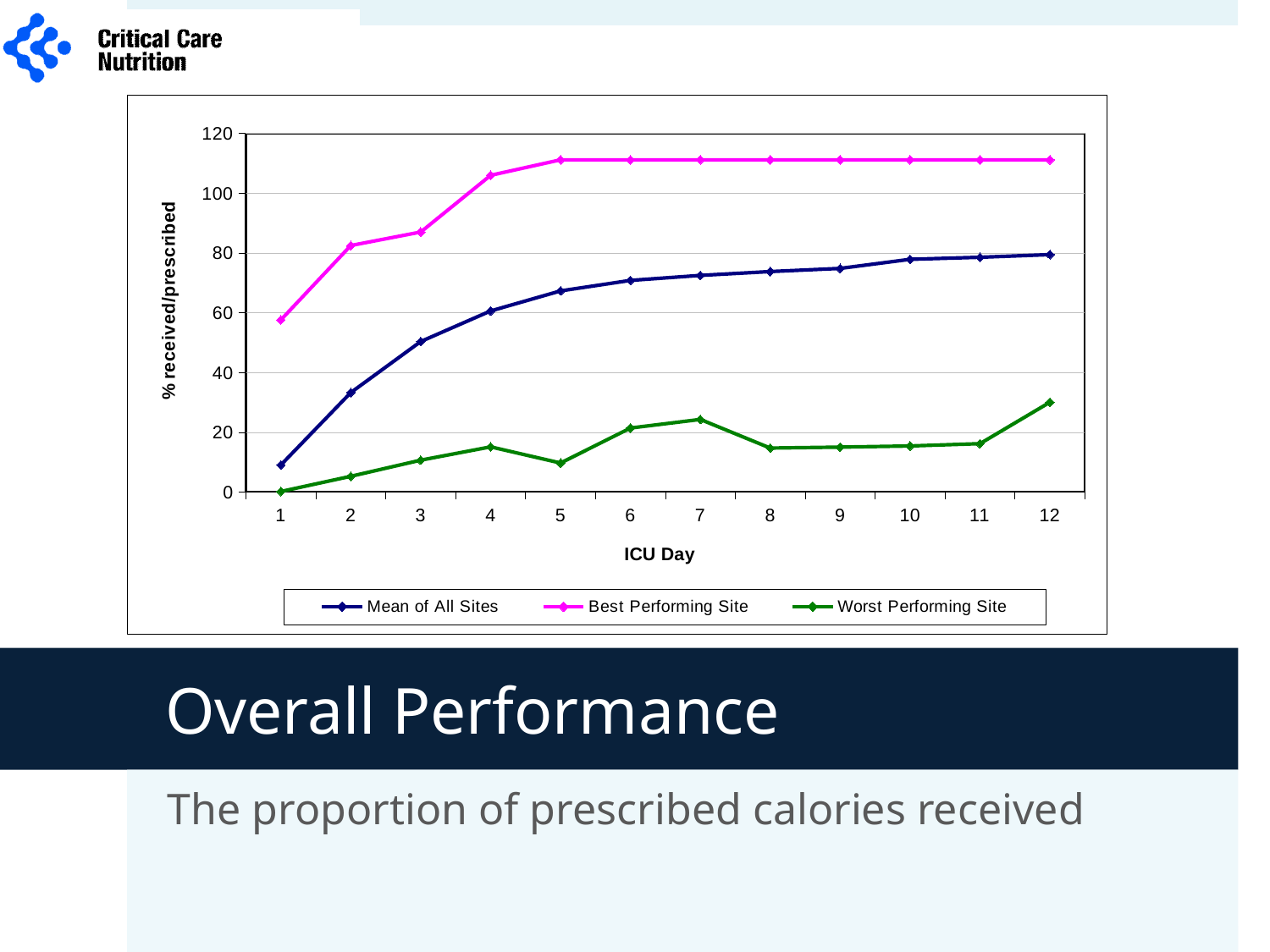
What kind of chart is shown on the slide? Line chart Does the Mean of All Sites line generally rise or fall from ICU Day 1 to ICU Day 12? Rise Which series has the lowest value on ICU Day 1? Worst Performing Site Is the value for Mean of All Sites on ICU Day 1 greater or less than 20? less How many series does the legend list? 3 What is the title of the y axis? % received/prescribed Is the value for Worst Performing Site on ICU Day 12 greater or less than 20? greater On which ICU Day is the Worst Performing Site at its lowest value? 1 On which ICU Day does the Worst Performing Site reach its highest value? 12 How many ICU days are plotted along the x axis? 12 Which series has the highest value on ICU Day 6? Best Performing Site Is the value for Best Performing Site on ICU Day 4 greater or less than 100? greater